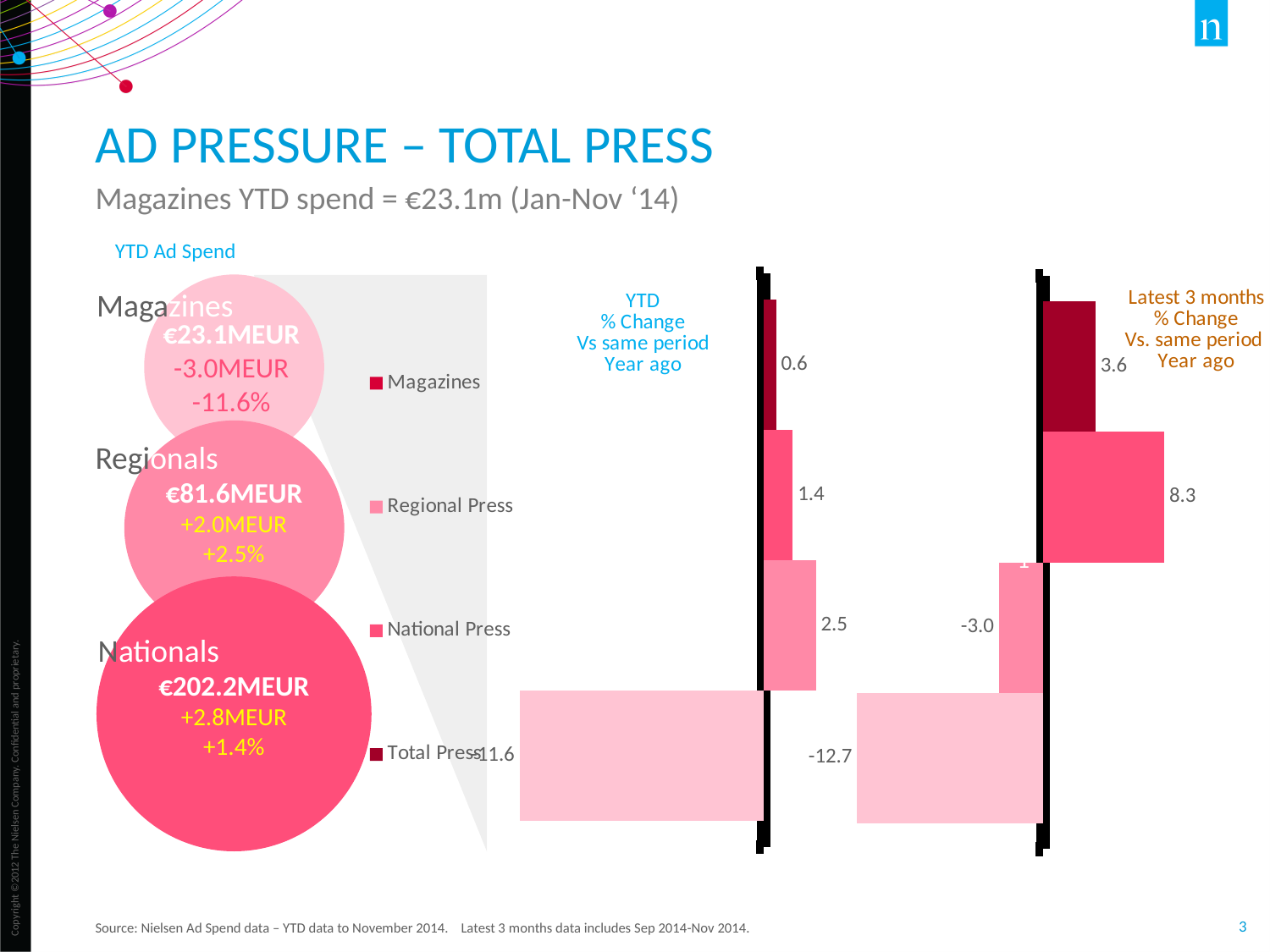
In the 'Latest 3 months % Change Vs. same period Year ago' bar chart, what is the highest value shown? 8.3 In the YTD Ad Spend bubble chart, what is the percentage change shown for Regionals? +2.5% In the YTD Ad Spend bubble chart, which category has the lowest YTD spend? Magazines In the YTD Ad Spend bubble chart, what is the YTD spend for Nationals? €202.2MEUR In the YTD Ad Spend bubble chart, what is the percentage change shown for Magazines? -11.6% How many bars are plotted in the 'Latest 3 months % Change' chart? 4 In the YTD Ad Spend bubble chart, what is the YTD spend for Magazines? €23.1MEUR In the YTD Ad Spend bubble chart, how much larger is the Nationals YTD spend than the Regionals YTD spend? €120.6MEUR How many entries does the legend between the bubble chart and the bar charts list? 4 In the 'YTD % Change Vs same period Year ago' bar chart, what is the lowest value shown? -11.6 In the YTD Ad Spend bubble chart, what is the YTD spend for Regionals? €81.6MEUR In the YTD Ad Spend bubble chart, which category has the highest YTD spend? Nationals